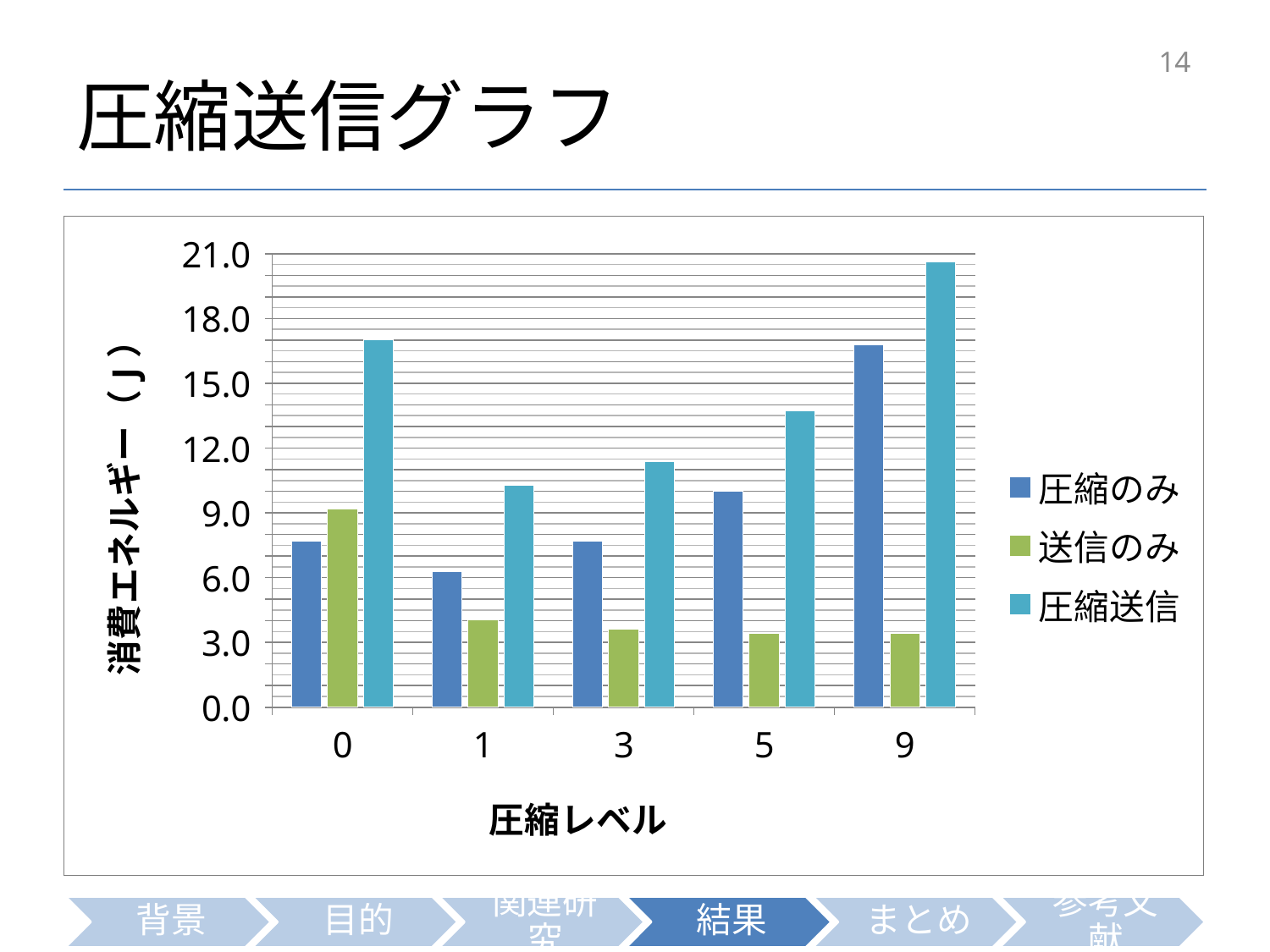
What kind of chart is shown on the slide? bar chart At which compression level is the 送信のみ value highest? 0 At which compression level is the 圧縮送信 value highest? 9 What is the title of the y axis? 消費エネルギー（J） Is the 圧縮送信 value at compression level 9 greater or less than 18.0? greater Is the 圧縮のみ value at compression level 5 greater or less than 9.0? greater How many series does the legend list? 3 At compression level 0, which is larger: 圧縮のみ or 送信のみ? 送信のみ Do the 圧縮送信 values rise or fall as the compression level increases from 1 to 9? rise Is the 送信のみ value at compression level 5 greater or less than 6.0? less At which compression level is the 圧縮のみ value lowest? 1 How many compression levels (categories) are shown on the x axis? 5